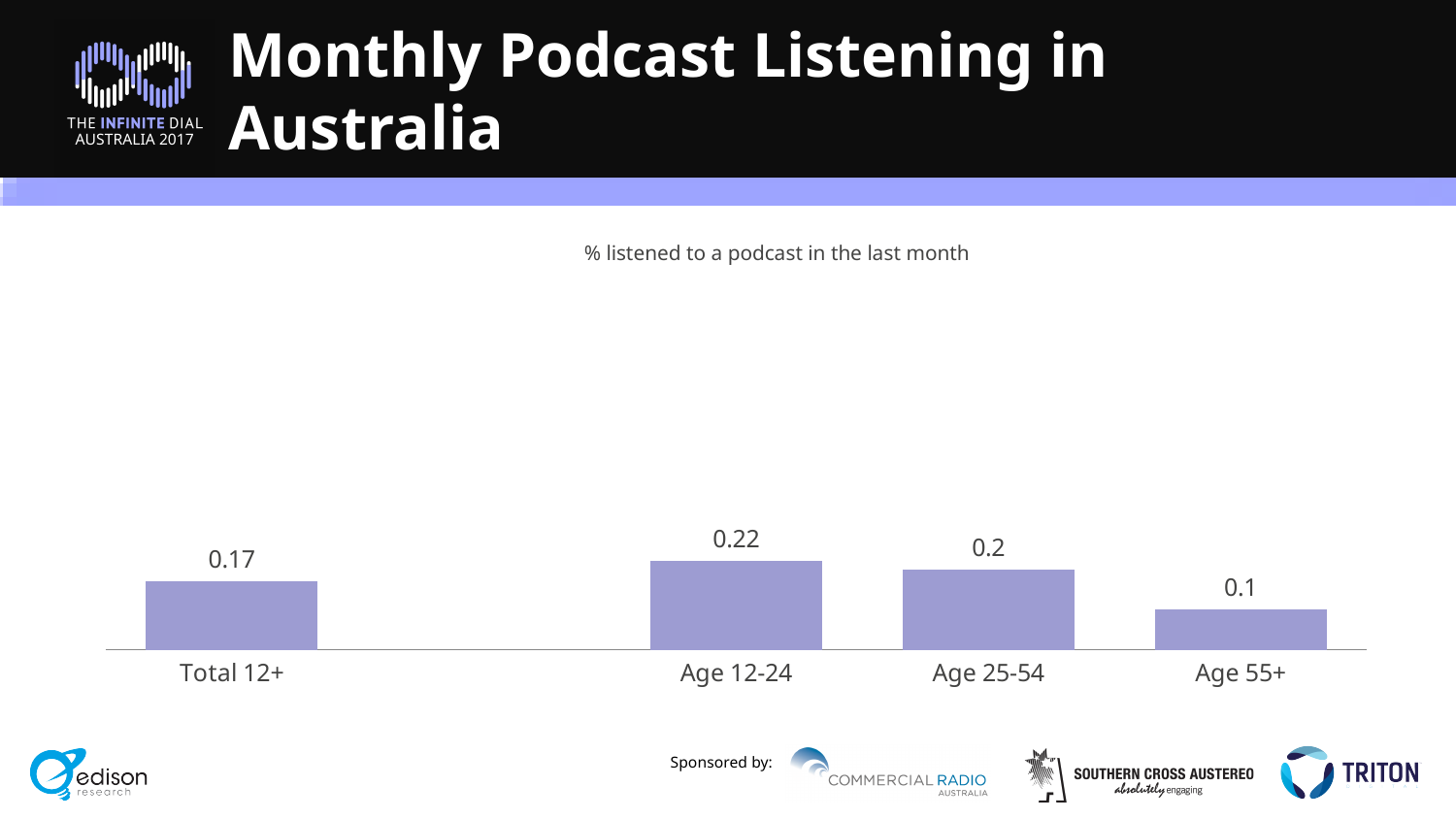
Which category has the highest value? Age 12-24 What is the value for Age 12-24? 0.22 What is the value for Age 25-54? 0.2 What is the difference between the values for Age 12-24 and Age 55+? 0.12 How many categories are shown in the chart? 4 What kind of chart is shown on the slide? Bar chart Which is larger, the value for Age 25-54 or the value for Age 55+? Age 25-54 What is the value for Age 55+? 0.1 What is the subtitle text shown above the chart? % listened to a podcast in the last month What is the value for Total 12+? 0.17 What is the difference between the values for Age 25-54 and Total 12+? 0.03 Which category has the lowest value? Age 55+